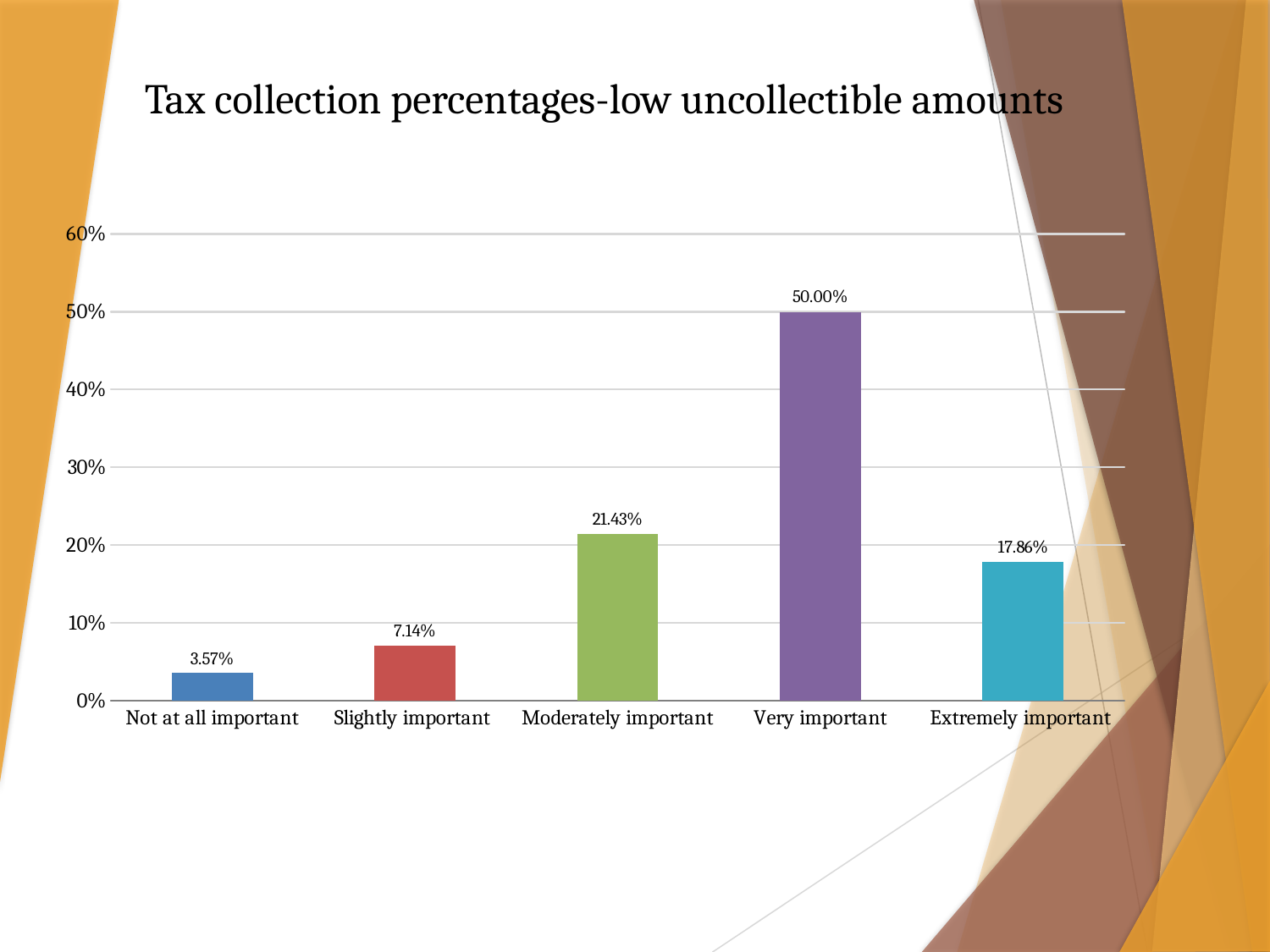
What is the difference between the values for Very important and Moderately important? 28.57% How many categories are shown on the x axis? 5 Is the value for Extremely important greater or less than 20%? less What kind of chart is shown on the slide? bar chart What is the difference between the values for Slightly important and Not at all important? 3.57% Which is larger, the value for Moderately important or the value for Extremely important? Moderately important What is the value for Very important? 50.00% What is the value for Not at all important? 3.57% What is the value for Extremely important? 17.86% Which category has the lowest value? Not at all important What is the value for Moderately important? 21.43% Which category has the highest value? Very important